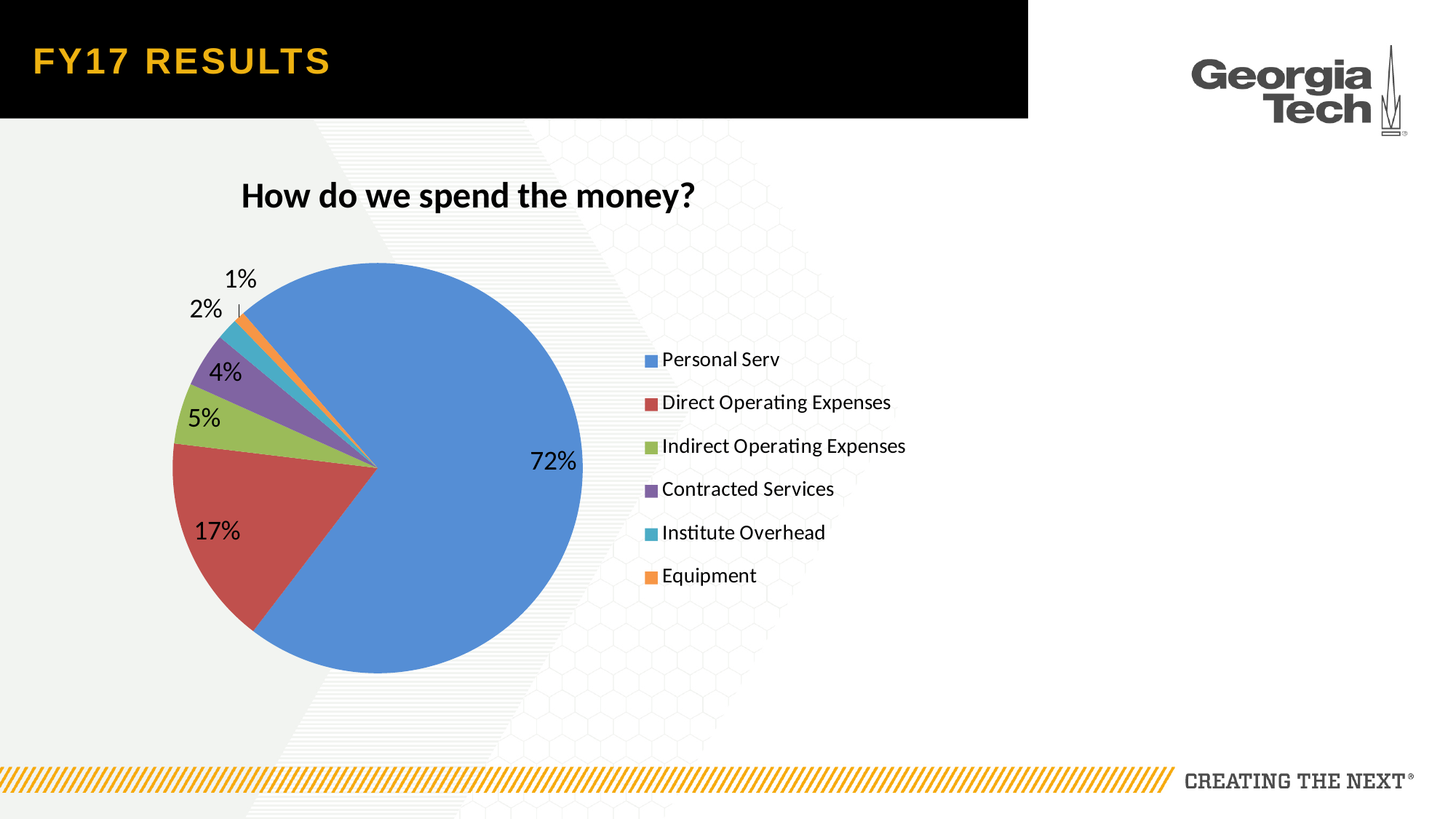
Which category has the smallest share of spending? Equipment What share of spending goes to Direct Operating Expenses? 17% What share of spending goes to Equipment? 1% What share of spending goes to Indirect Operating Expenses? 5% What kind of chart is shown on the slide? pie chart Which category has the largest share of spending? Personal Serv What is the title of the chart? How do we spend the money? How many categories does the legend list? 6 What is the difference between the shares for Personal Serv and Direct Operating Expenses? 55%